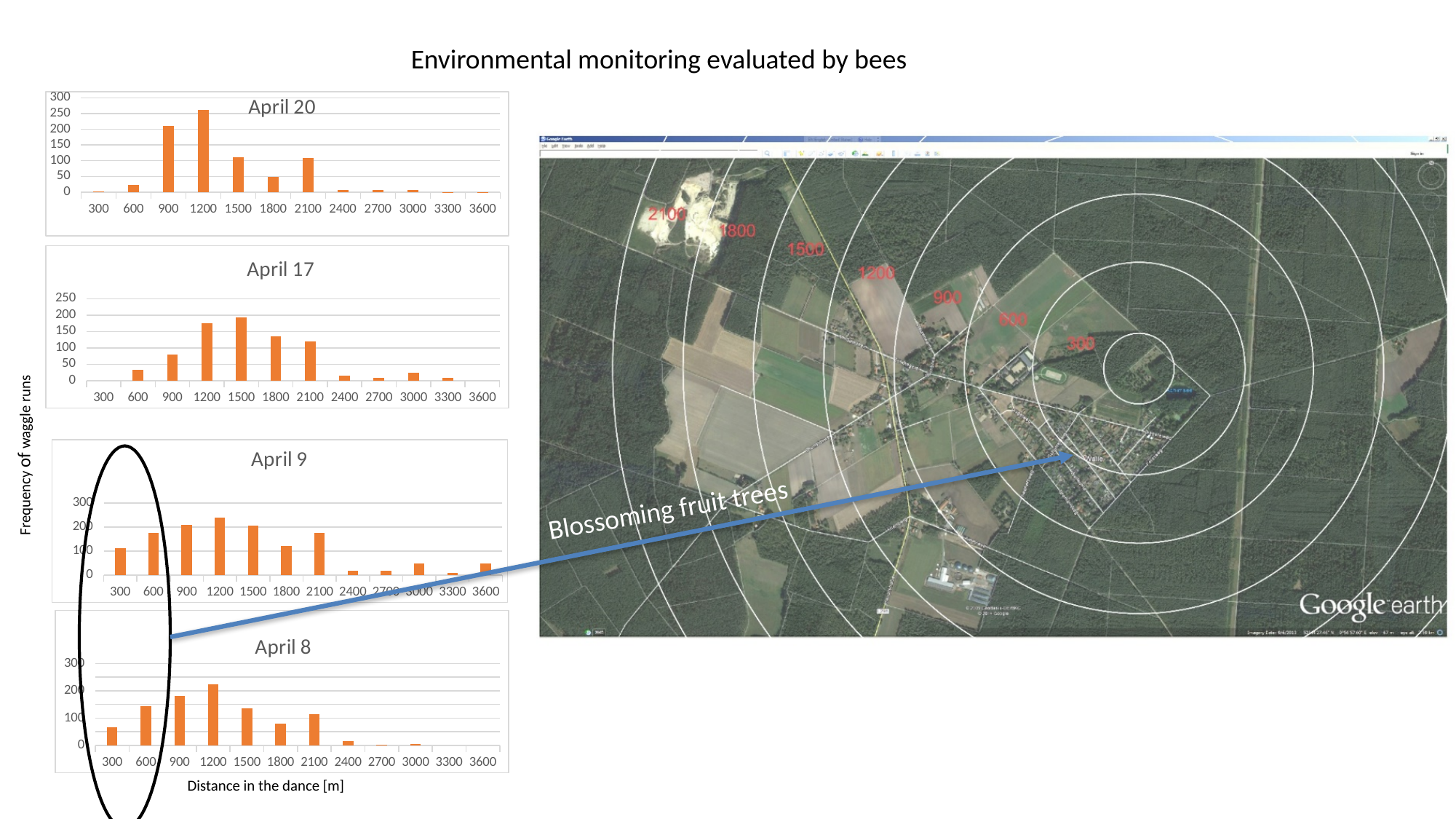
In the April 17 chart, which distance has the highest frequency of waggle runs? 1500 In the April 20 chart, which distance has the highest frequency of waggle runs? 1200 What kind of chart is the April 20 chart? bar chart In the April 9 chart, is the value for 2400 greater or less than 100? less How many distance categories are shown on the x axis of the April 17 chart? 12 In the April 9 chart, which is larger, the value for 900 or the value for 1800? 900 What is the x-axis label shown below the April 8 chart? Distance in the dance [m] In the April 20 chart, which is larger, the value for 900 or the value for 1500? 900 In the April 8 chart, is the value for 300 greater or less than 100? less In the April 17 chart, is the value for 900 greater or less than 100? less In the April 9 chart, which distance has the highest frequency of waggle runs? 1200